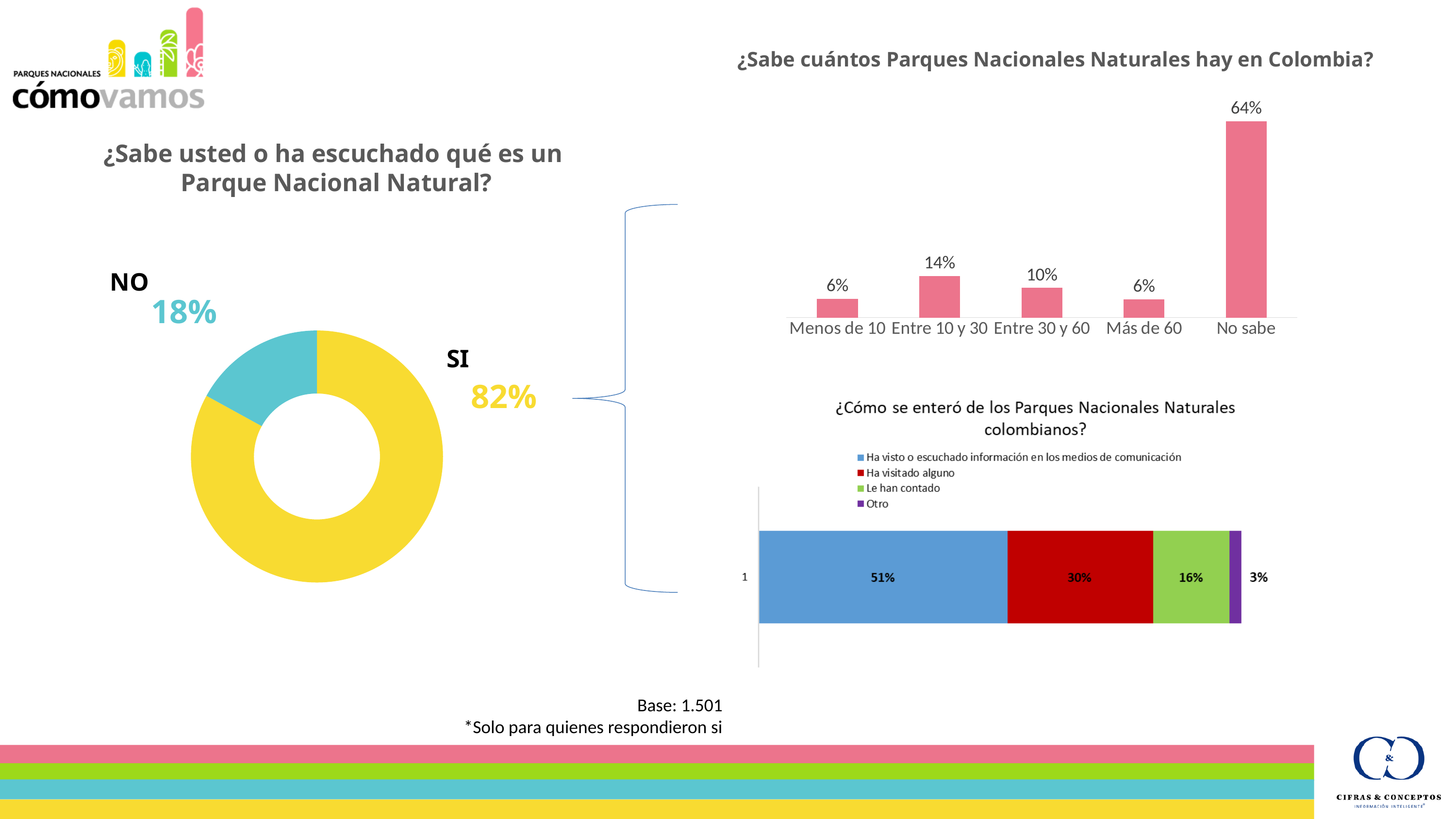
In the donut chart '¿Sabe usted o ha escuchado qué es un Parque Nacional Natural?', what share answered SI? 82% In the bar chart '¿Sabe cuántos Parques Nacionales Naturales hay en Colombia?', which category has the highest value? No sabe In the bar chart '¿Sabe cuántos Parques Nacionales Naturales hay en Colombia?', how many categories are shown? 5 In the bar chart '¿Sabe cuántos Parques Nacionales Naturales hay en Colombia?', what is the value for 'No sabe'? 64% In the donut chart '¿Sabe usted o ha escuchado qué es un Parque Nacional Natural?', what share answered NO? 18% In the bar chart '¿Sabe cuántos Parques Nacionales Naturales hay en Colombia?', what is the difference between 'Entre 10 y 30' and 'Entre 30 y 60'? 4% In the stacked bar chart '¿Cómo se enteró de los Parques Nacionales Naturales colombianos?', how many series does the legend list? 4 In the bar chart '¿Sabe cuántos Parques Nacionales Naturales hay en Colombia?', what is the value for 'Entre 10 y 30'? 14% In the stacked bar chart '¿Cómo se enteró de los Parques Nacionales Naturales colombianos?', what is the value for 'Ha visitado alguno'? 30% In the donut chart '¿Sabe usted o ha escuchado qué es un Parque Nacional Natural?', what is the difference between the SI and NO shares? 64% In the bar chart '¿Sabe cuántos Parques Nacionales Naturales hay en Colombia?', which is larger: 'Entre 30 y 60' or 'Más de 60'? Entre 30 y 60 In the stacked bar chart '¿Cómo se enteró de los Parques Nacionales Naturales colombianos?', what is the total of the stacked bar? 100%